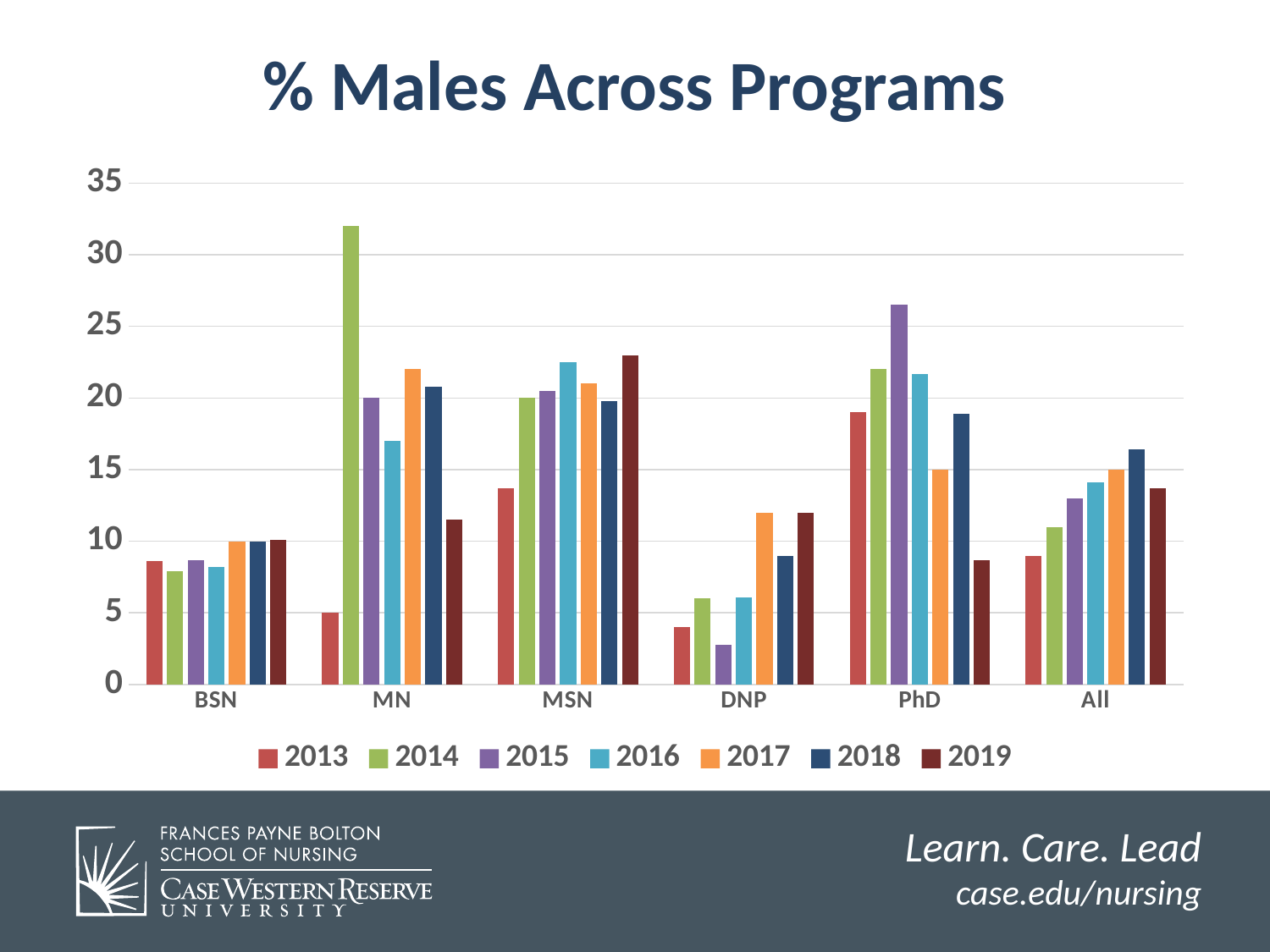
Is the value for PhD in 2015 greater or less than 25? greater What kind of chart is shown on the slide? bar chart How many program categories are shown on the x axis? 6 For the PhD program, which is larger: the value for 2015 or the value for 2019? 2015 How many series does the legend list? 7 Which year has the highest % males for the MN program? 2014 What is the title of the chart? % Males Across Programs Is the value for DNP in 2013 greater or less than 5? less For the All category, do the values rise or fall from 2013 to 2018? rise Which year has the lowest % males for the DNP program? 2015 Which year has the lowest % males for the MN program? 2013 Is the value for MN in 2014 greater or less than 30? greater